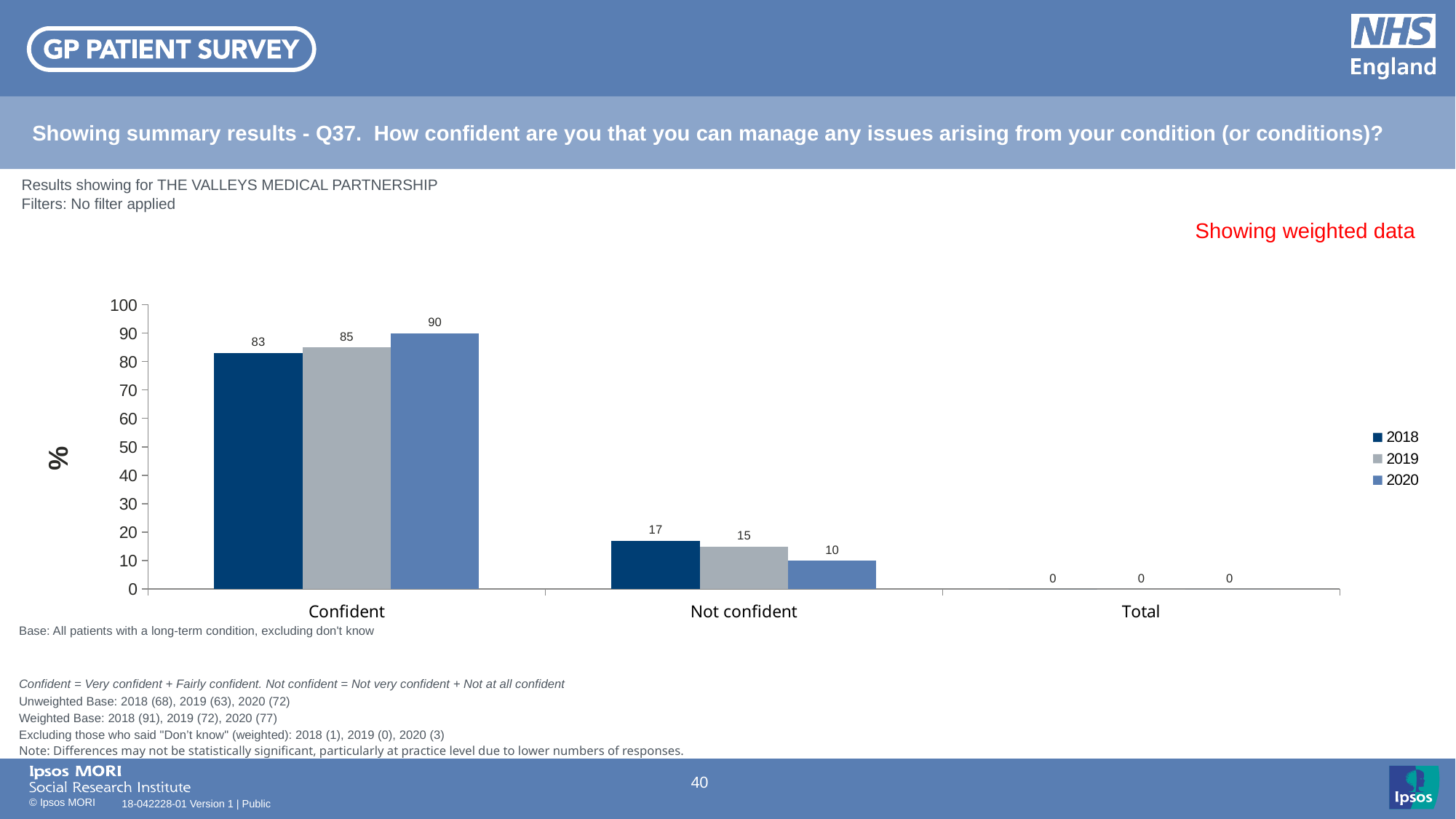
Which is larger: the Not confident value for 2019 or for 2020? 2019 How many series does the legend list? 3 How many categories are shown on the x axis? 3 What is the value for Confident in 2019? 85 Which year has the highest value for Confident? 2020 Which year has the lowest value for Not confident? 2020 Is the value for Confident in 2018 greater or less than 80? greater What is the value for Not confident in 2018? 17 Do the Confident values rise or fall from 2018 to 2020? rise What is the difference between the Confident values for 2020 and 2018? 7 What kind of chart is shown on the slide? bar chart What is the value for Confident in 2020? 90